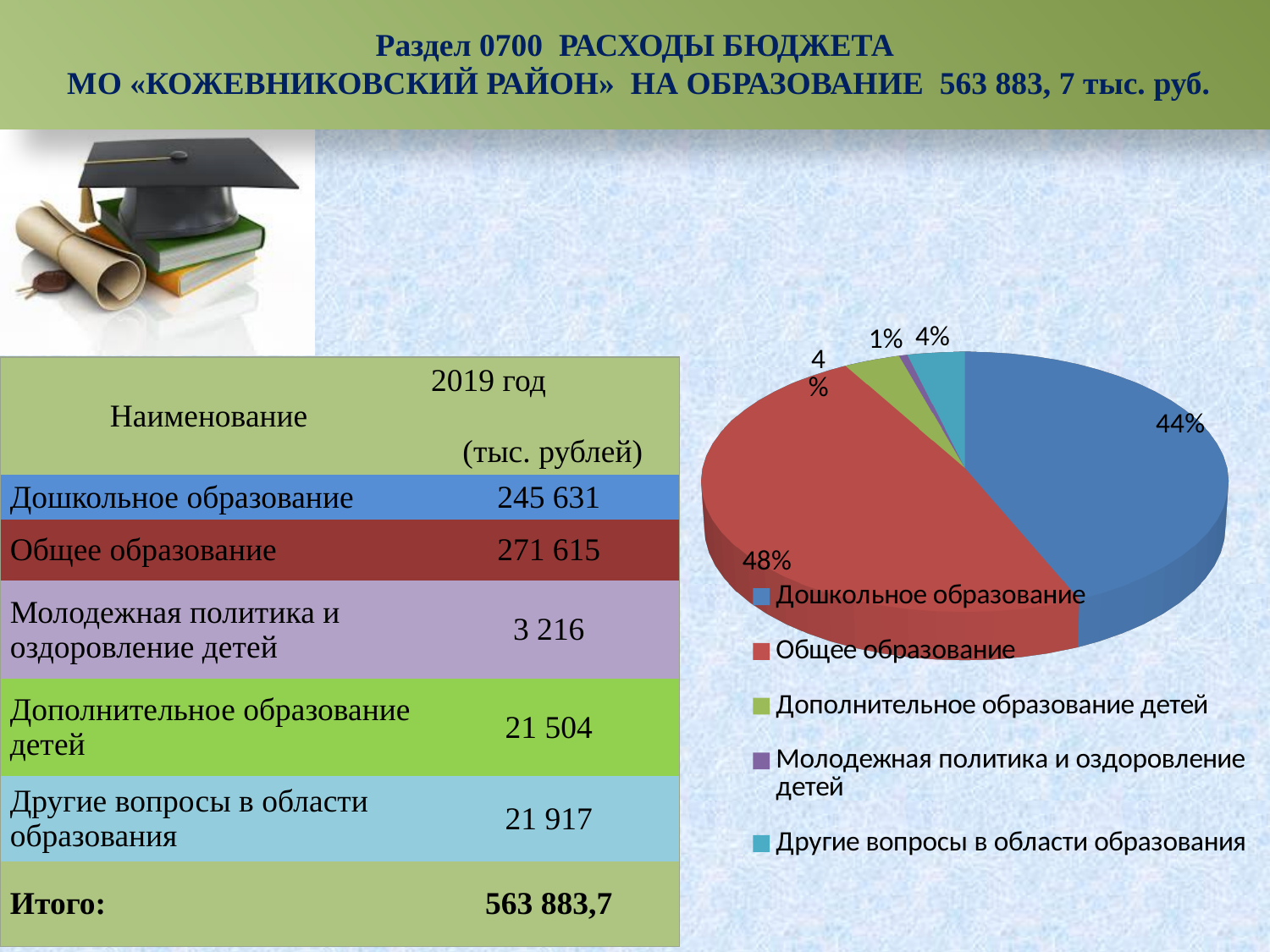
What share of the pie does Дошкольное образование have? 44% What is the difference in percentage points between the shares of Общее образование and Дошкольное образование? 4 What kind of chart is shown on the slide? pie chart Which category has the smallest slice of the pie? Молодежная политика и оздоровление детей How many categories does the legend of the pie chart list? 5 Which is larger: the share of Дошкольное образование or the share of Дополнительное образование детей? Дошкольное образование What colour is the slice for Общее образование? red What share of the pie does Молодежная политика и оздоровление детей have? 1% How many slices does the pie chart have? 5 Which category has the largest slice of the pie? Общее образование What share of the pie does Другие вопросы в области образования have? 4%